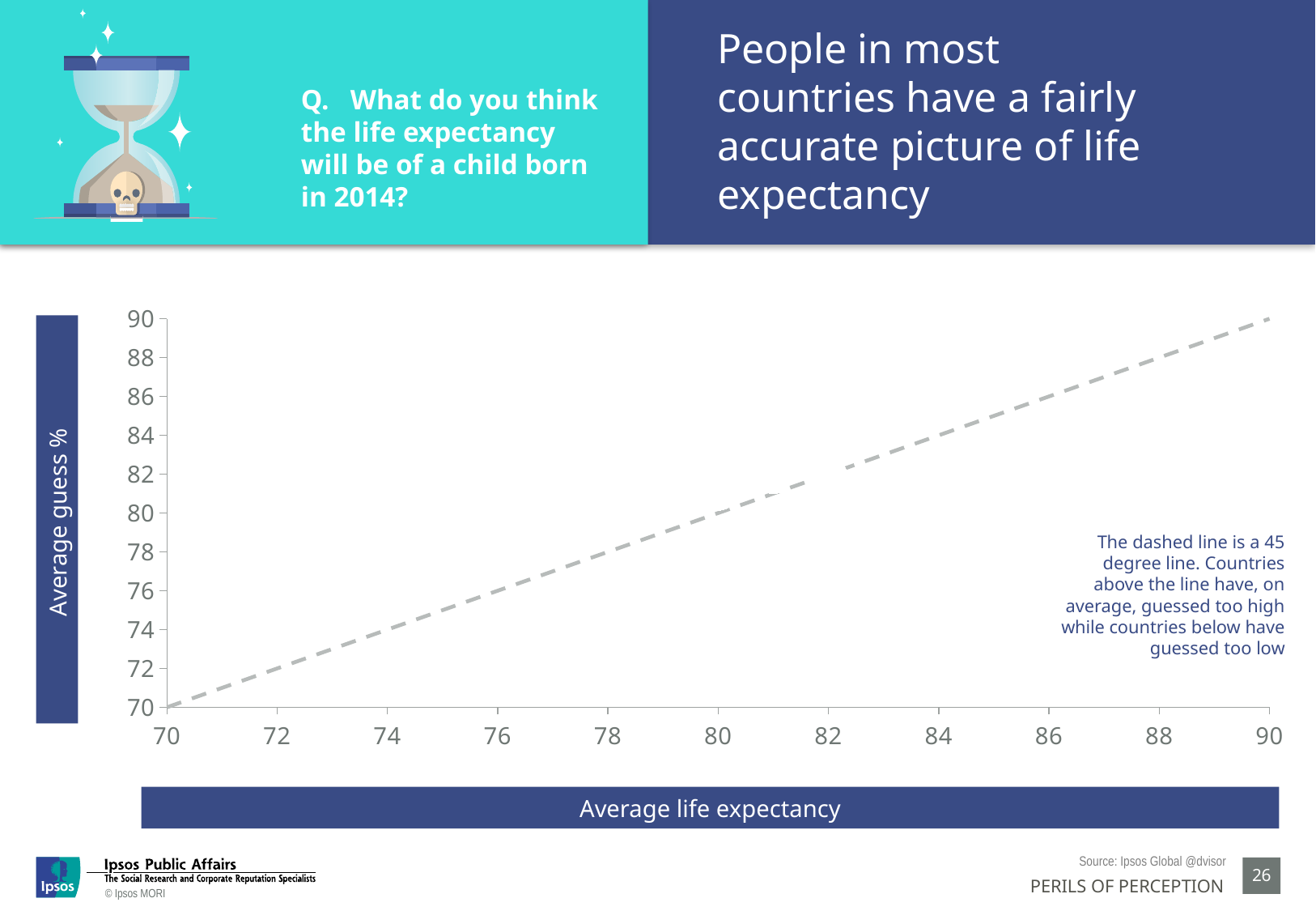
What average guess value does the dashed 45 degree line reach at an average life expectancy of 90? 90 At an average life expectancy of 80, is the dashed line's average guess value greater or less than 84? less Does the dashed line rise or fall as the average life expectancy increases along the x axis? rises At an average life expectancy of 86, is the dashed line's average guess value greater or less than 80? greater What is the label of the horizontal axis of the chart? Average life expectancy What average guess value does the dashed 45 degree line have at an average life expectancy of 70? 70 What is the label of the vertical axis of the chart? Average guess %